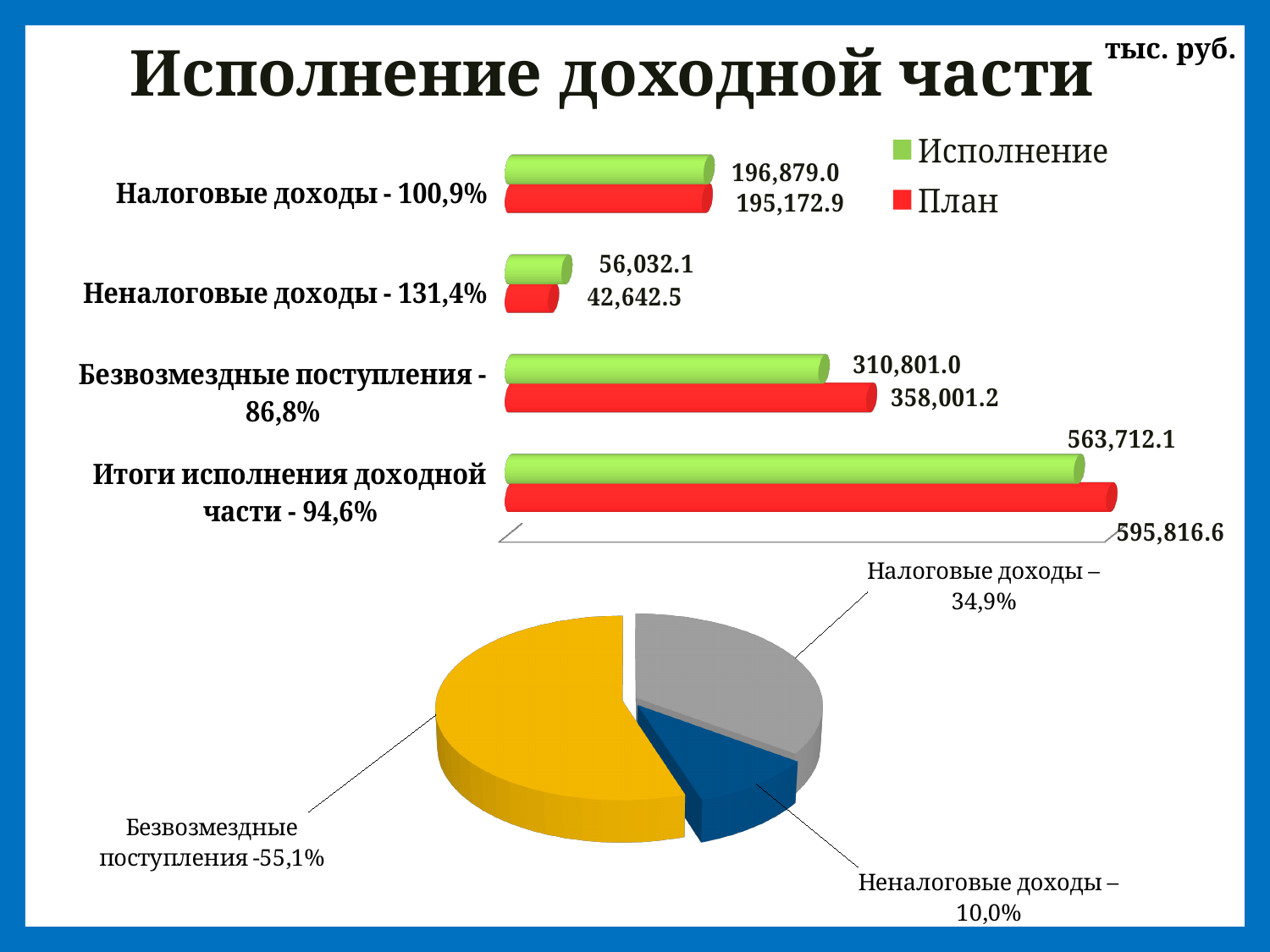
In the bar chart, what is the Исполнение value for Неналоговые доходы? 56,032.1 How many series does the legend of the bar chart list? 2 In the pie chart, what share does Безвозмездные поступления have? 55,1% In the bar chart, what is the difference between the Исполнение and План values for Неналоговые доходы? 13,389.6 In the bar chart, which is larger for Налоговые доходы: Исполнение or План? Исполнение In the bar chart, what is the difference between the План and Исполнение values for Безвозмездные поступления? 47,200.2 In the bar chart, which category has the highest Исполнение value? Итоги исполнения доходной части What type of chart is the bottom chart on the slide? Pie chart In the bar chart, what is the План value for Безвозмездные поступления? 358,001.2 In the bar chart, which category has the lowest План value? Неналоговые доходы In the pie chart, which slice is the smallest? Неналоговые доходы In the bar chart, what is the План value for Итоги исполнения доходной части? 595,816.6